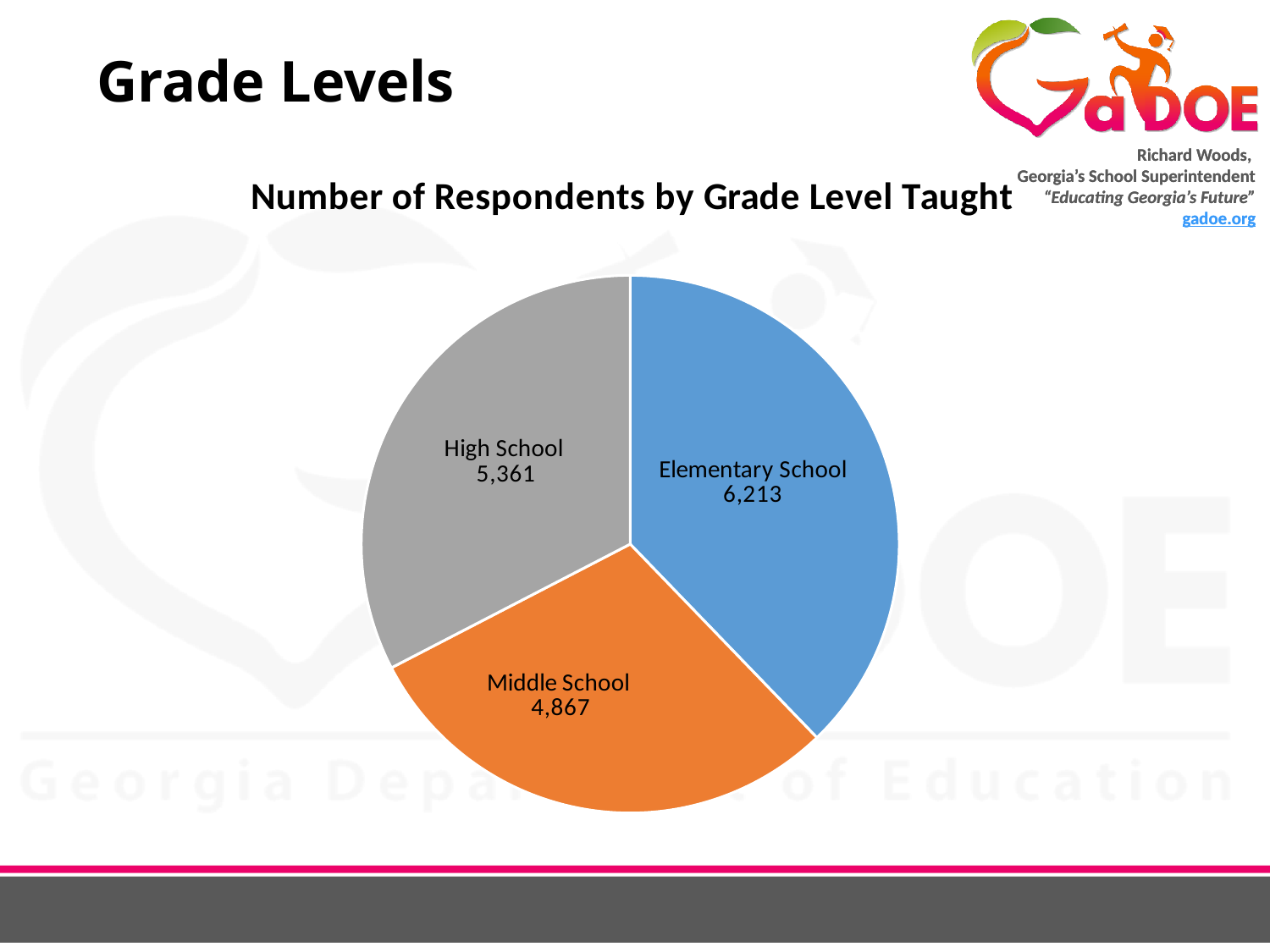
How many grade level categories are shown in the pie chart? 3 What type of chart is shown on the slide? Pie chart Which grade level has the highest number of respondents? Elementary School How many respondents taught High School? 5,361 How many respondents taught Elementary School? 6,213 What is the title of the chart? Number of Respondents by Grade Level Taught Which grade level has the lowest number of respondents? Middle School What is the difference between the number of Elementary School and Middle School respondents? 1,346 What colour is the Middle School slice? Orange What is the difference between the number of High School and Middle School respondents? 494 How many respondents taught Middle School? 4,867 Which has more respondents, High School or Middle School? High School